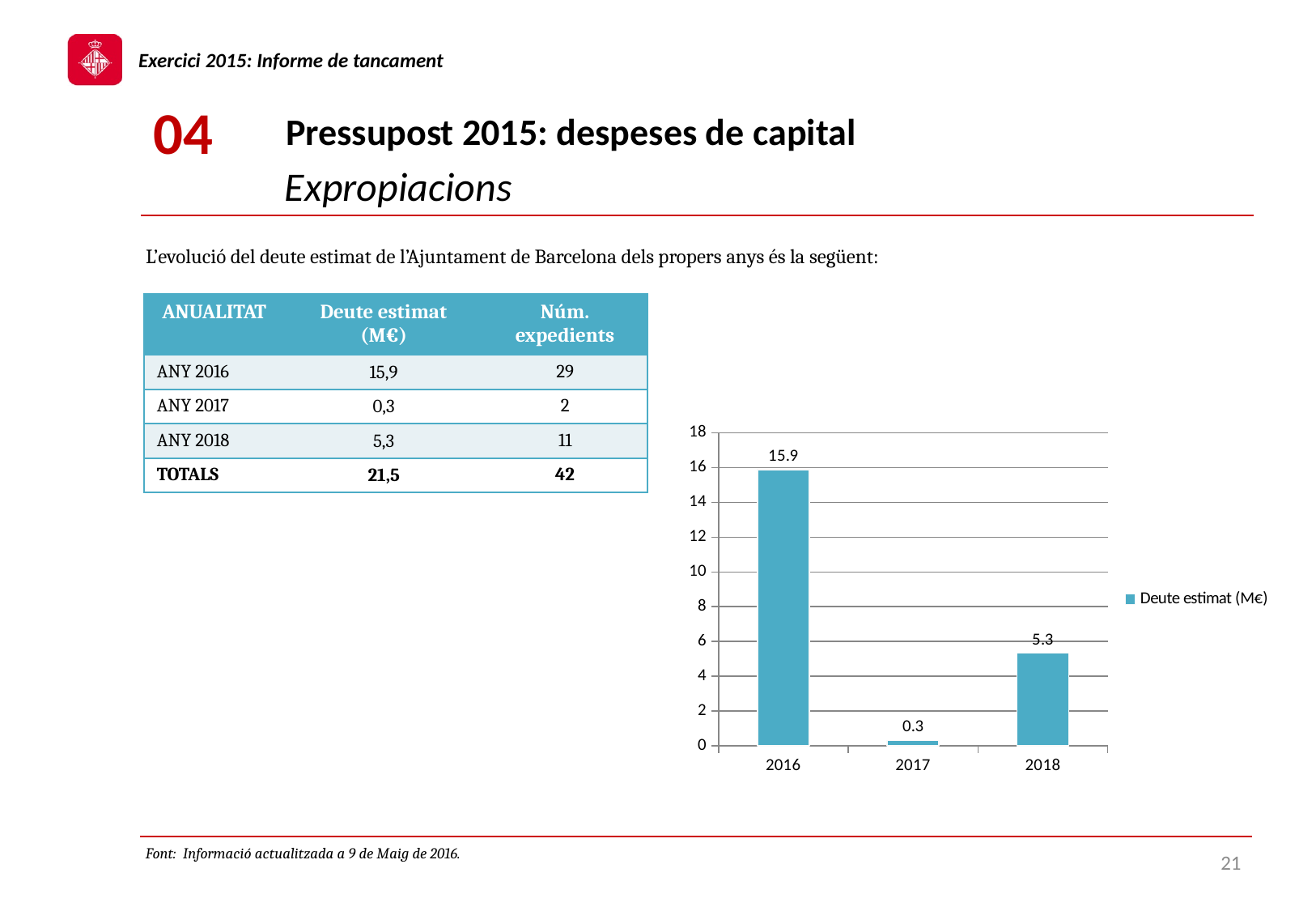
How many years are shown on the x axis of the chart? 3 What is the value for 2017 in the chart? 0.3 What is the difference between the values for 2018 and 2017 in the chart? 5.0 Which year has the lowest value in the chart? 2017 Is the value for 2016 in the chart greater or less than 14? greater Which is larger in the chart, the value for 2018 or the value for 2017? 2018 Which year has the highest value in the chart? 2016 What is the value for 2016 in the chart? 15.9 What is the difference between the values for 2016 and 2018 in the chart? 10.6 What kind of chart is shown on the slide? bar chart How many series does the chart legend list? 1 What is the value for 2018 in the chart? 5.3